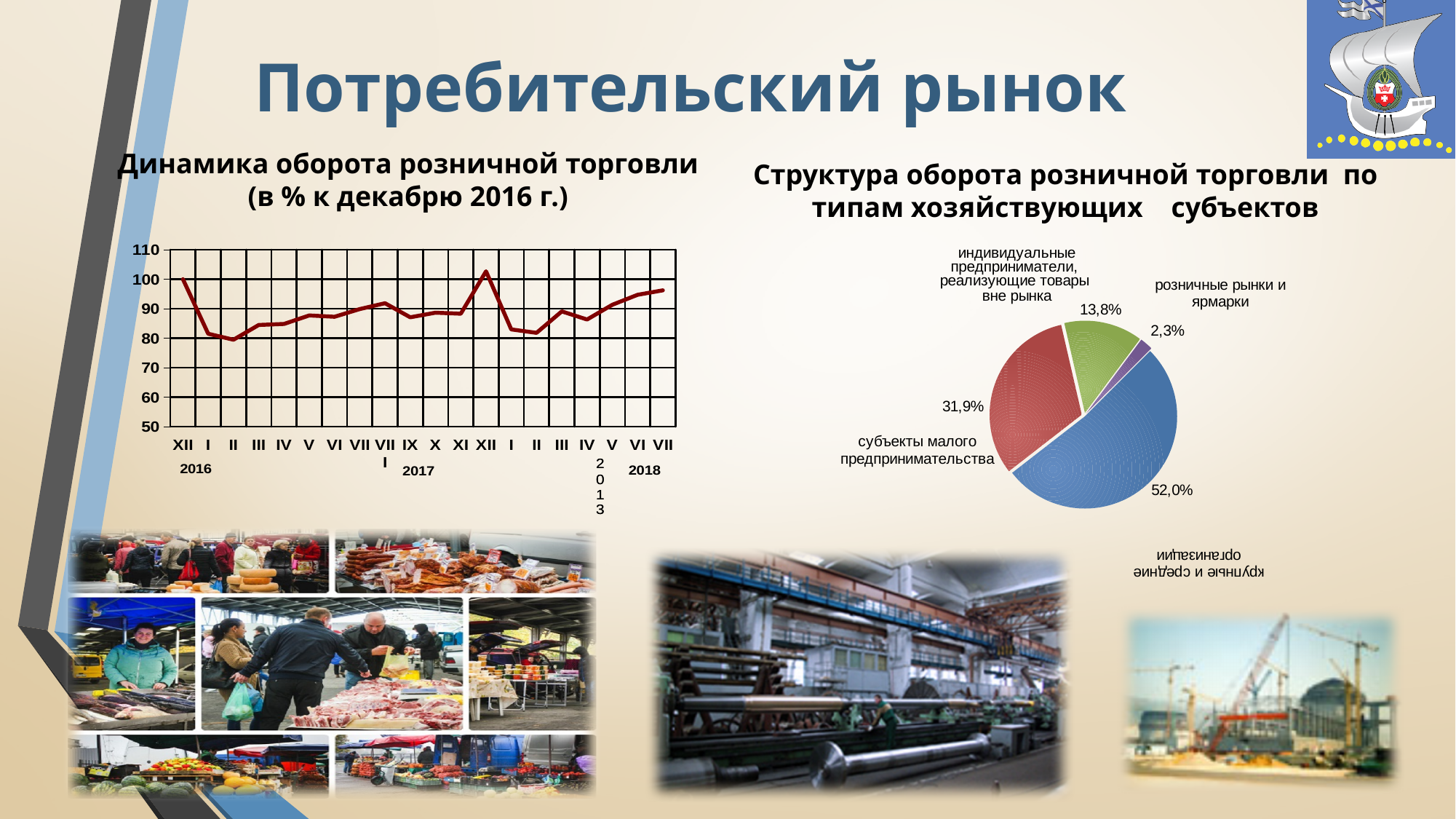
In the pie chart 'Структура оборота розничной торговли по типам хозяйствующих субъектов', what share is shown for 'индивидуальные предприниматели, реализующие товары вне рынка'? 13,8% In the pie chart 'Структура оборота розничной торговли по типам хозяйствующих субъектов', how many percentage points larger is the 52,0% slice than the 'субъекты малого предпринимательства' slice? 20,1 In the pie chart 'Структура оборота розничной торговли по типам хозяйствующих субъектов', which category has the smallest share? розничные рынки и ярмарки In the chart 'Динамика оборота розничной торговли (в % к декабрю 2016 г.)', is the value for II 2017 greater or less than 90? less What kind of chart is 'Динамика оборота розничной торговли (в % к декабрю 2016 г.)'? line chart In the pie chart 'Структура оборота розничной торговли по типам хозяйствующих субъектов', what share is shown for 'субъекты малого предпринимательства'? 31,9% In the pie chart 'Структура оборота розничной торговли по типам хозяйствующих субъектов', what is the share of the largest slice? 52,0% In the pie chart 'Структура оборота розничной торговли по типам хозяйствующих субъектов', what share is shown for 'розничные рынки и ярмарки'? 2,3% How many slices does the pie chart 'Структура оборота розничной торговли по типам хозяйствующих субъектов' have? 4 In the chart 'Динамика оборота розничной торговли (в % к декабрю 2016 г.)', do the values rise or fall from IV 2018 to VII 2018? rise In the chart 'Динамика оборота розничной торговли (в % к декабрю 2016 г.)', is the value for XII 2017 greater or less than 100? greater In the pie chart 'Структура оборота розничной торговли по типам хозяйствующих субъектов', which is larger: 'индивидуальные предприниматели, реализующие товары вне рынка' or 'розничные рынки и ярмарки'? индивидуальные предприниматели, реализующие товары вне рынка